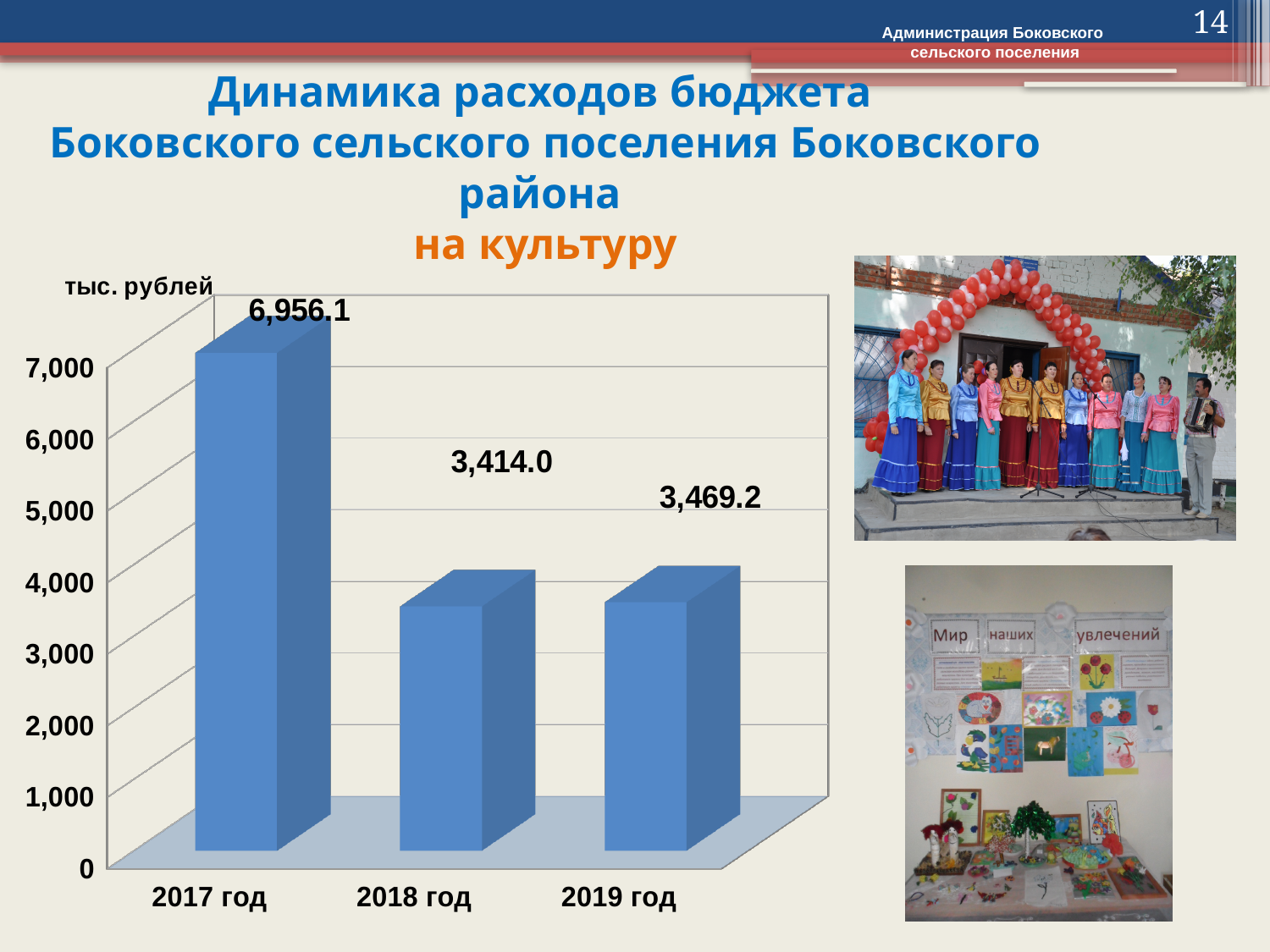
How many years are shown on the chart? 3 What is the value for 2018 год? 3,414.0 What is the difference between the values for 2017 год and 2018 год? 3,542.1 What unit is indicated for the values on the chart? тыс. рублей Which is larger, the value for 2018 год or 2019 год? 2019 год Which year has the highest value? 2017 год What is the difference between the values for 2019 год and 2018 год? 55.2 Is the value for 2017 год greater or less than 6,000? greater What is the value for 2017 год? 6,956.1 What kind of chart is shown on the slide? bar chart Which year has the lowest value? 2018 год What is the value for 2019 год? 3,469.2